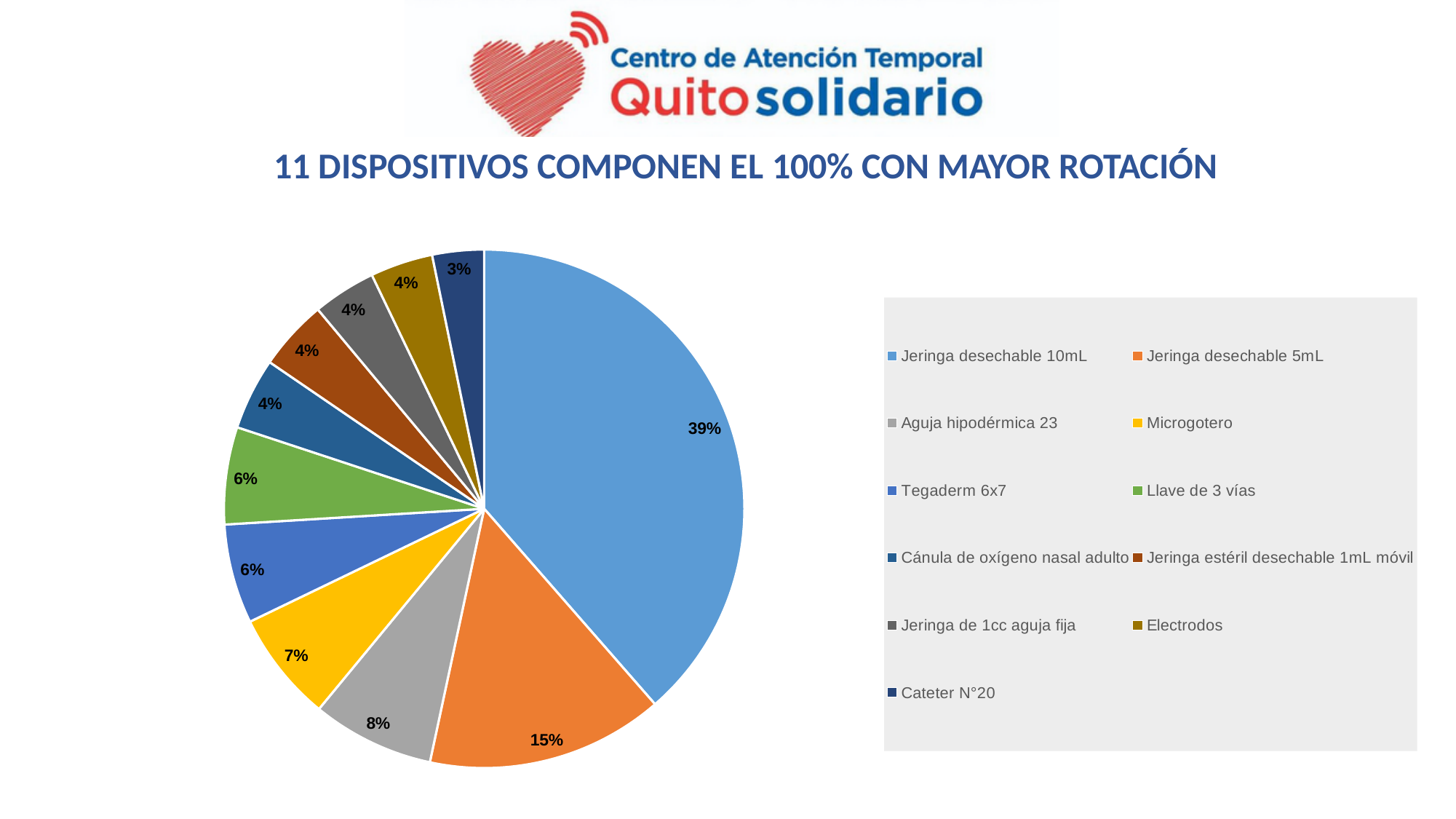
What is the difference in percentage points between Jeringa desechable 10mL and Jeringa desechable 5mL? 24 How many categories does the legend list? 11 What share of the pie does Microgotero represent? 7% What share of the pie does Aguja hipodérmica 23 represent? 8% What share of the pie does Jeringa desechable 5mL represent? 15% What kind of chart is shown on the slide? pie chart Which is larger, the slice for Microgotero or the slice for Llave de 3 vías? Microgotero Which category has the smallest slice of the pie? Cateter N°20 What is the title of the chart on the slide? 11 DISPOSITIVOS COMPONEN EL 100% CON MAYOR ROTACIÓN Which category has the largest slice of the pie? Jeringa desechable 10mL